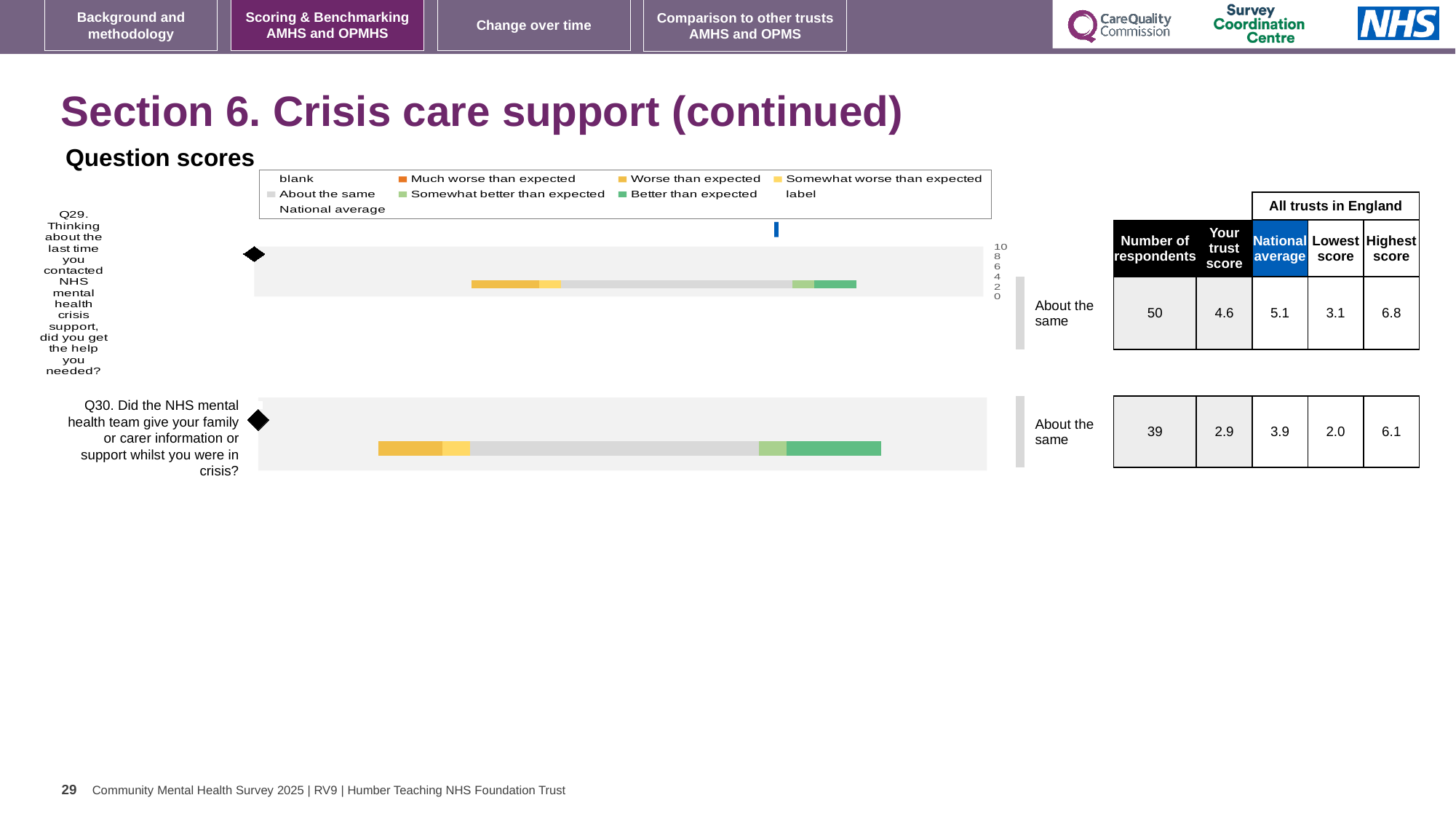
In the legend, what colour represents 'Better than expected'? Green For the Q30 chart, what is the highest score among all trusts in England? 6.1 For the Q30 chart, how many respondents are shown? 39 For the Q29 chart, what is the trust's score shown in the table? 4.6 For the Q29 chart, what is the national average score? 5.1 For the Q29 chart, what is the difference between the highest score (6.8) and the lowest score (3.1)? 3.7 What kind of chart is used to show the question scores on this slide? bar chart For the Q30 chart, what is the lowest score among all trusts in England? 2.0 For the Q29 chart, which benchmark category is the trust's score placed in? About the same How many questions (Q29 and Q30) are plotted as bars on this slide? 2 For the Q30 chart, what is the difference between the national average (3.9) and the trust score (2.9)? 1.0 For the Q29 chart, which is larger: the trust's score or the national average? National average